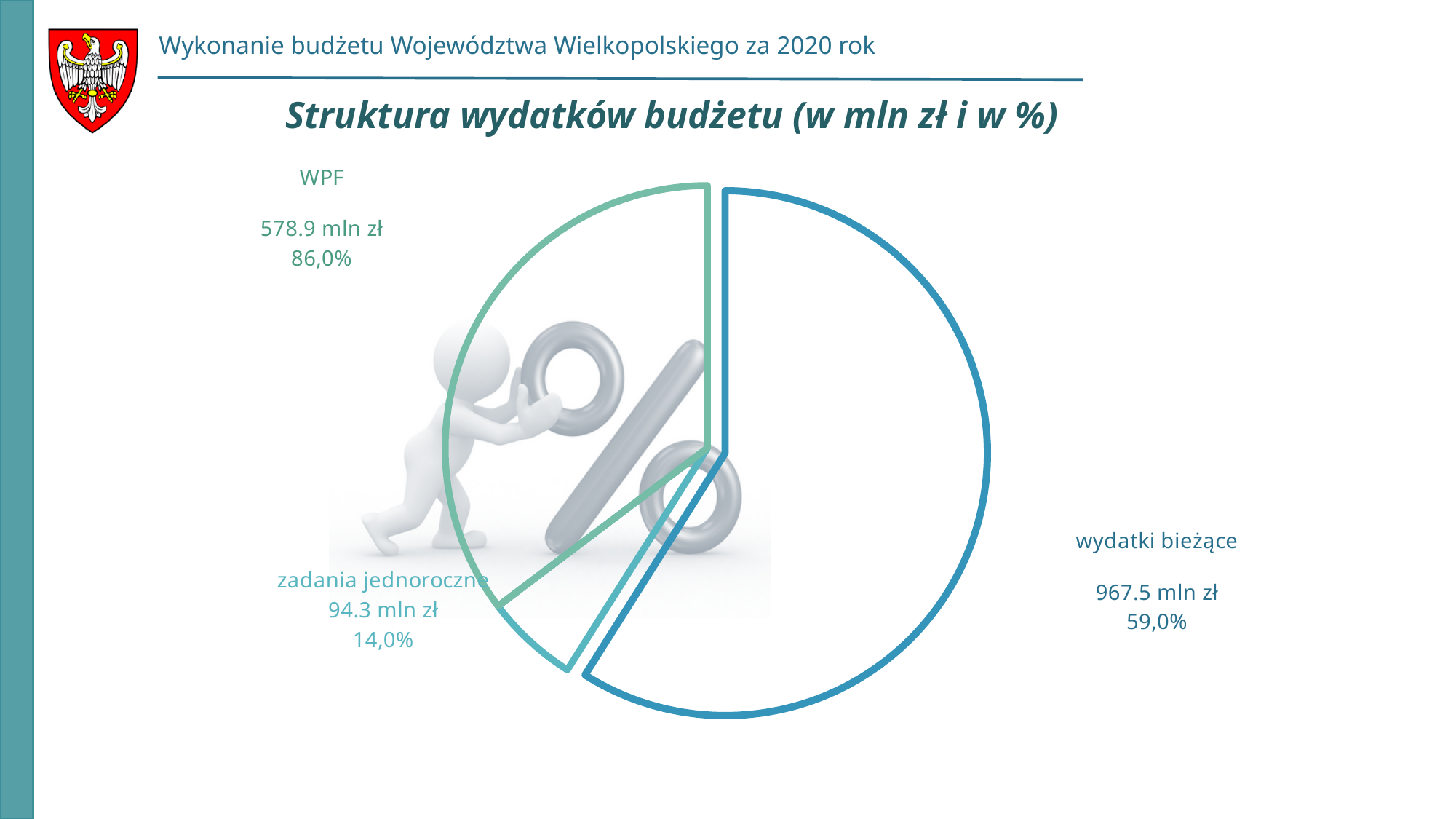
What percentage is shown for WPF? 86,0% What is the value in mln zł for zadania jednoroczne? 94.3 mln zł What is the value in mln zł for WPF? 578.9 mln zł What is the difference in mln zł between wydatki bieżące and WPF? 388.6 mln zł Which is larger in mln zł, WPF or zadania jednoroczne? WPF How many slices does the pie chart have? 3 What is the title of the chart? Struktura wydatków budżetu (w mln zł i w %) Which category has the largest value in mln zł? wydatki bieżące What percentage is shown for wydatki bieżące? 59,0% What kind of chart is shown on the slide? pie chart What is the value in mln zł for wydatki bieżące? 967.5 mln zł Which category has the smallest value in mln zł? zadania jednoroczne